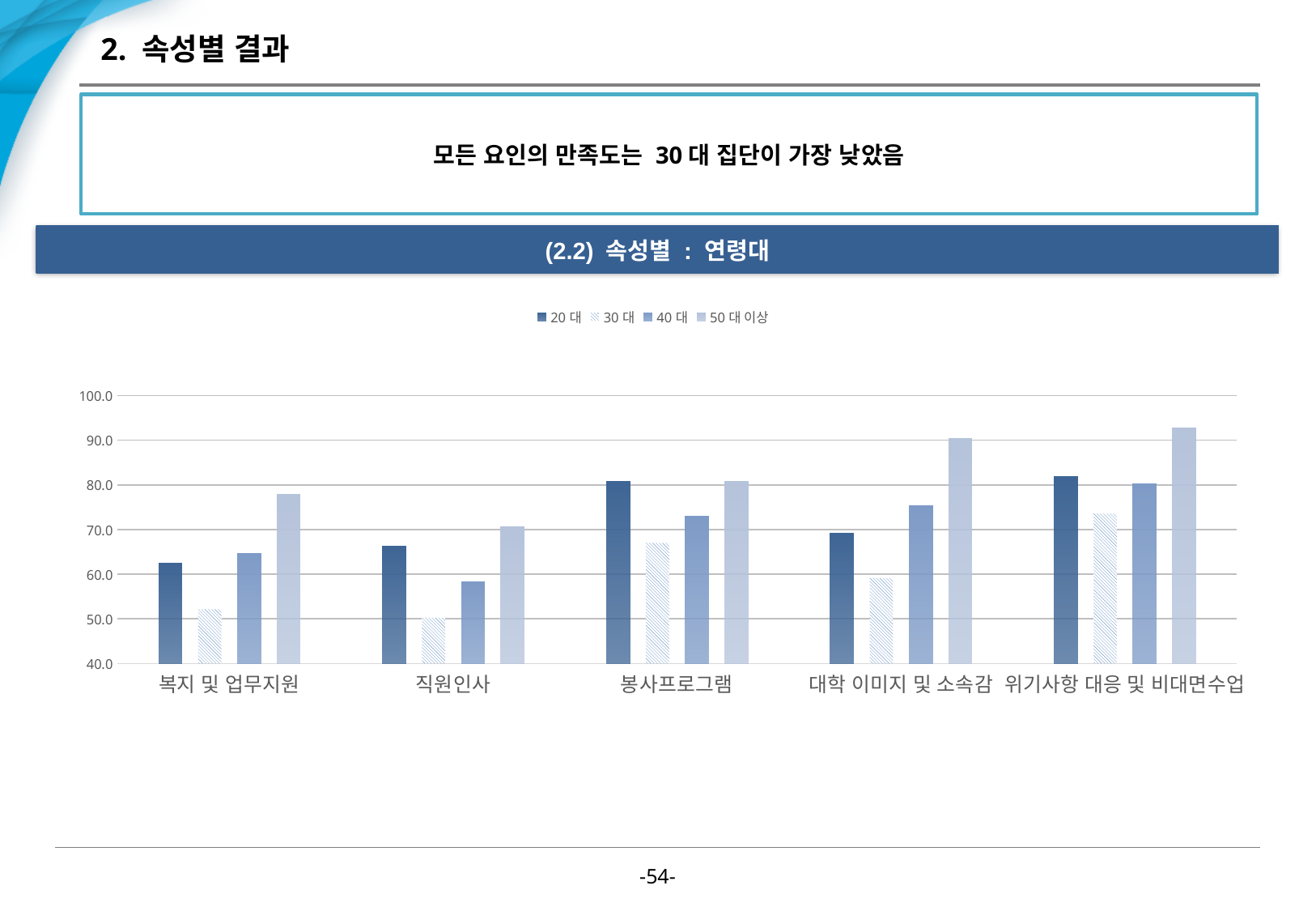
How many series does the legend list? 4 Which series is drawn with a hatched pattern in the legend? 30 대 In 직원인사, which is larger: the value for 20 대 or for 40 대? 20 대 Is the value for 20 대 in 봉사프로그램 greater or less than 70? greater Which category has the highest value for 50 대 이상? 위기사항 대응 및 비대면수업 Is the value for 30 대 in 복지 및 업무지원 greater or less than 60? less How many categories are shown on the x axis? 5 Is the value for 30 대 in 직원인사 greater or less than 60? less What kind of chart is shown on the slide? bar chart Which category has the lowest value for 20 대? 복지 및 업무지원 Which series has the lowest value in 복지 및 업무지원? 30 대